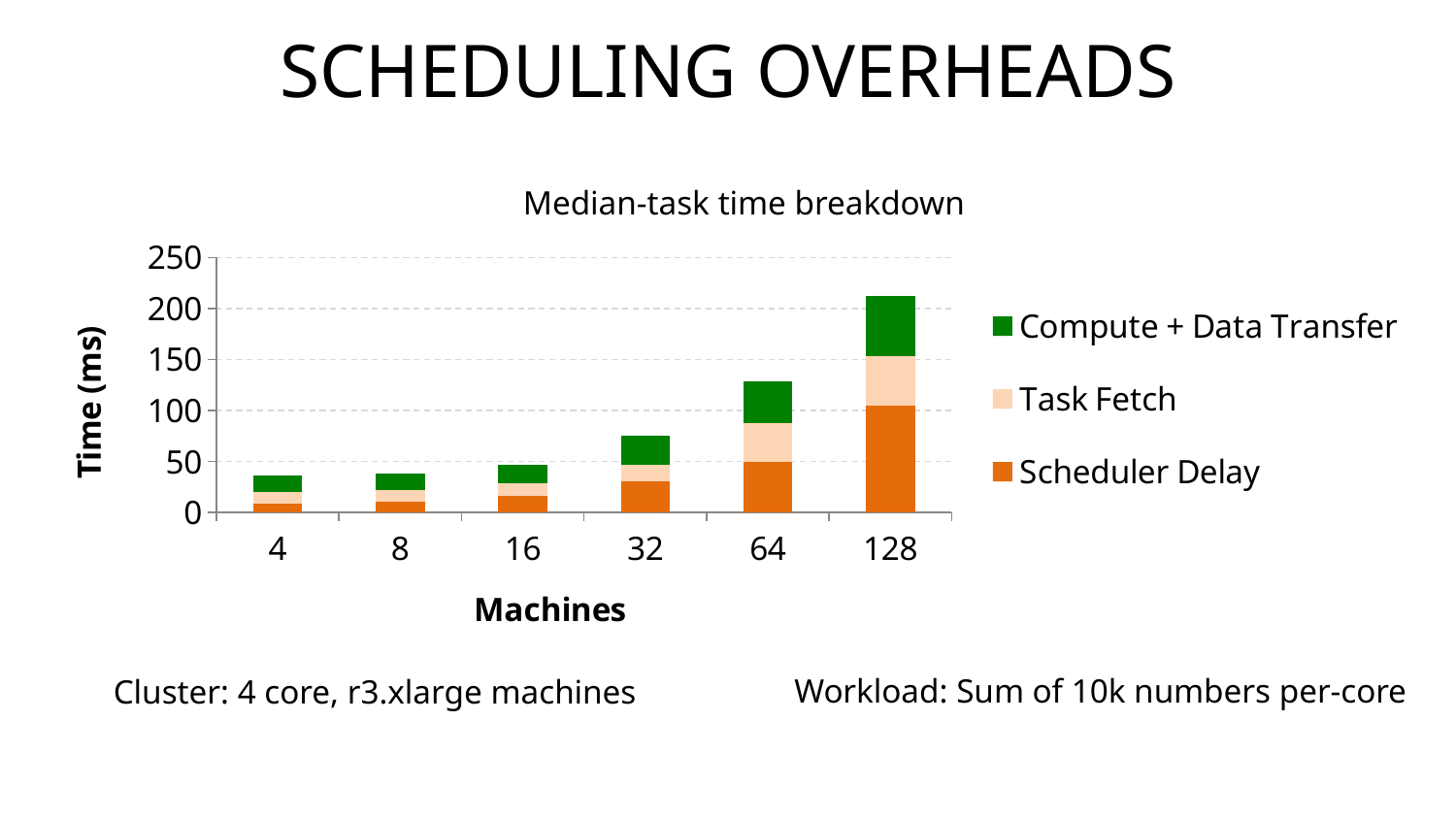
Is the total median-task time for 32 machines greater or less than 100 ms? less Is the total median-task time for 64 machines greater or less than 100 ms? greater Is the Scheduler Delay for 128 machines greater or less than 50 ms? greater Does the total median-task time rise or fall as the number of machines increases? rises How many machine-count categories are shown on the x axis? 6 Which machine count has the highest total median-task time? 128 What is the title of the chart? Median-task time breakdown Which has a larger total median-task time, 32 machines or 64 machines? 64 machines How many series does the legend list? 3 What kind of chart is shown on the slide? stacked bar chart